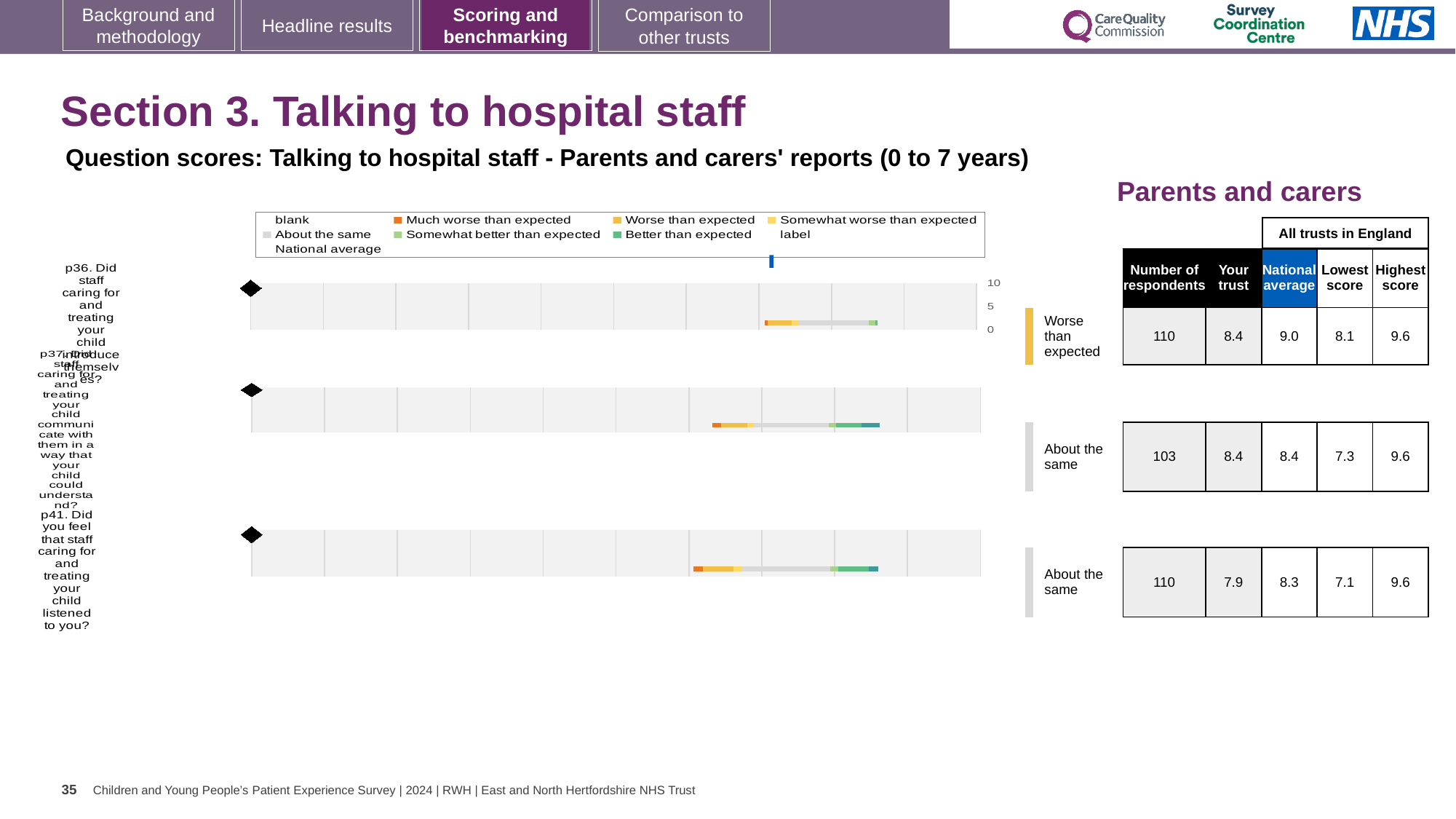
In the table, what is the 'Your trust' score for p36 (Did staff caring for and treating your child introduce themselves)? 8.4 In the table, how many respondents are listed for p37 (Did staff communicate with them in a way that your child could understand)? 103 In the table, what is the national average for p41 (Did you feel that staff caring for and treating your child listened to you)? 8.3 What colour does the legend use for 'Much worse than expected'? orange What benchmark category is shown next to the p36 bar? Worse than expected How many survey questions (bars) are plotted in the chart? 3 In the table, what is the lowest score across all trusts in England for p41? 7.1 What kind of chart is shown on the slide? bar chart What is the highest tick value shown on the chart's numeric axis? 10 Which of the three questions has the lowest 'Your trust' score in the table? p41 For p41, which is larger: the 'Your trust' score or the national average? National average For p36, what is the difference between the national average and the 'Your trust' score? 0.6